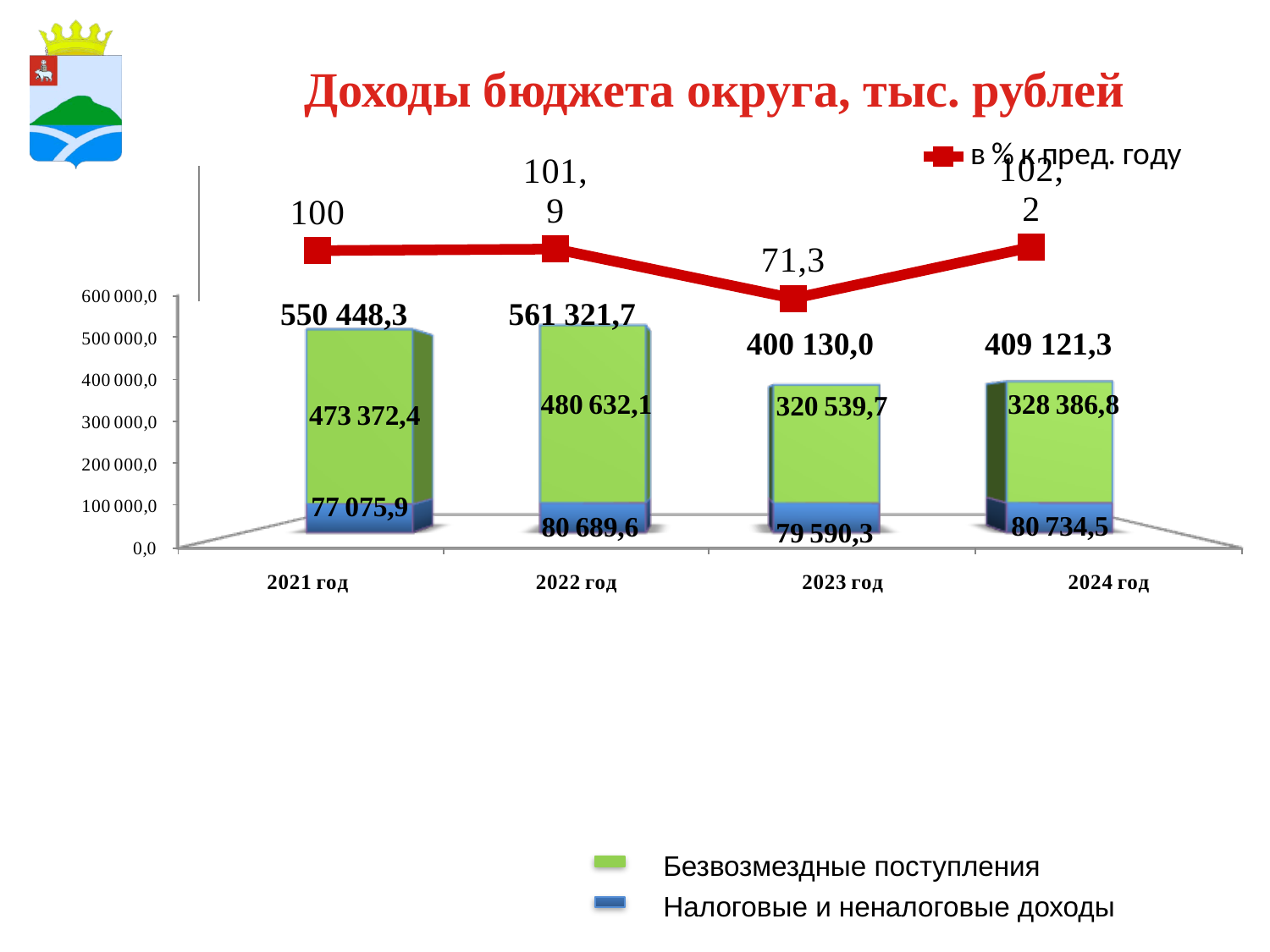
What is the title of the chart? Доходы бюджета округа, тыс. рублей What is the difference between Безвозмездные поступления in 2022 год and 2023 год? 160 092,4 What is the value of Налоговые и неналоговые доходы for 2021 год? 77 075,9 How many years are shown on the x axis? 4 What is the total budget revenue shown for 2022 год? 561 321,7 Which year has the highest total budget revenue? 2022 год Which year has the lowest value on the line 'в % к пред. году'? 2023 год What is the difference between the total revenue for 2022 год and 2021 год? 10 873,4 Which year has the lowest total budget revenue? 2023 год What is the value of the line 'в % к пред. году' for 2023 год? 71,3 What is the value of Безвозмездные поступления for 2023 год? 320 539,7 Which is larger: Безвозмездные поступления in 2024 год or in 2021 год? 2021 год